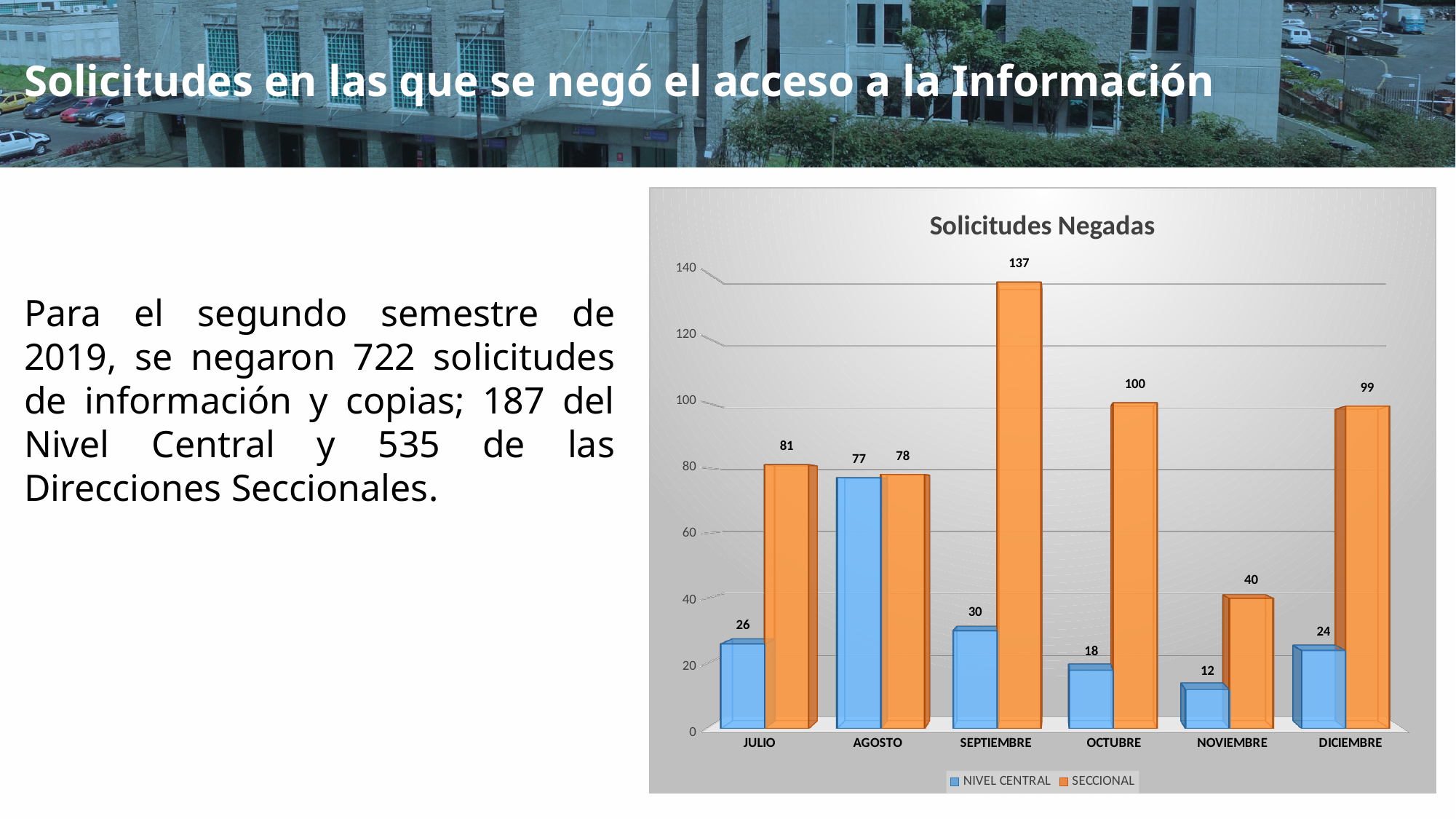
How many series does the legend list? 2 What is the value for SECCIONAL in SEPTIEMBRE? 137 What is the value for NIVEL CENTRAL in AGOSTO? 77 Which month has the lowest NIVEL CENTRAL value? NOVIEMBRE How many months are shown on the x axis? 6 Which month has the highest SECCIONAL value? SEPTIEMBRE Is the SECCIONAL value for JULIO greater or less than 100? less What is the difference between the SECCIONAL and NIVEL CENTRAL values in OCTUBRE? 82 What is the title of the chart? Solicitudes Negadas Which is larger in DICIEMBRE, NIVEL CENTRAL or SECCIONAL? SECCIONAL What kind of chart is shown? bar chart What is the value for NIVEL CENTRAL in NOVIEMBRE? 12